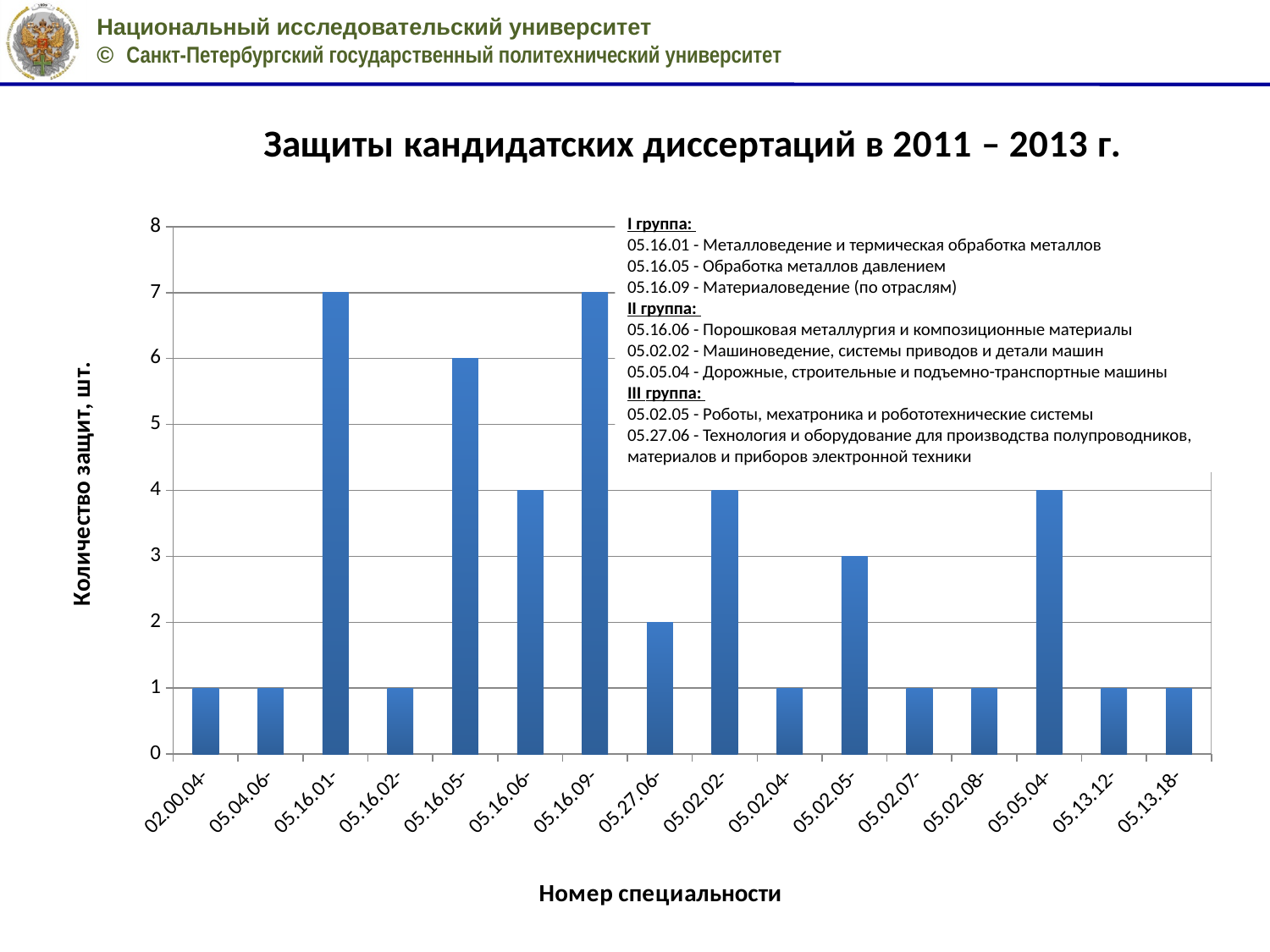
How many dissertation defenses are shown for specialty 05.16.05? 6 Is the value for 05.16.09 greater or less than 5? greater What is the highest value reached by any bar in the chart? 7 What is the title of the chart? Защиты кандидатских диссертаций в 2011 – 2013 г. What is the title of the vertical axis? Количество защит, шт. What is the value for specialty 05.02.05? 3 What is the value for specialty 05.27.06? 2 What is the value for specialty 05.16.06? 4 How many specialty categories are shown on the x axis? 16 What is the difference between the values for 05.16.01 and 05.16.05? 1 Which has a larger value, 05.02.02 or 05.02.05? 05.02.02 What kind of chart is shown on the slide? bar chart